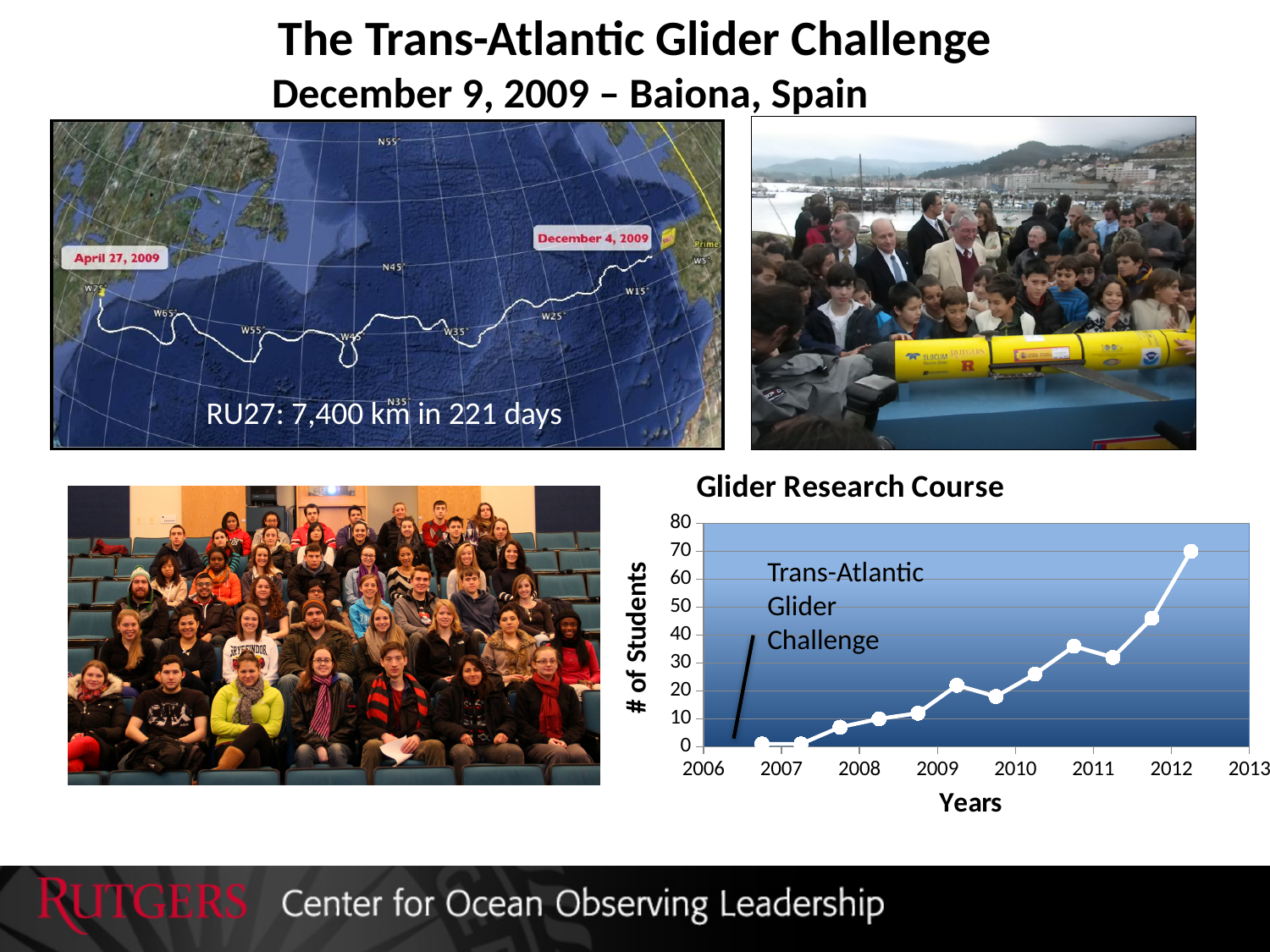
On the Glider Research Course chart, is the value of the highest point greater or less than 80? less What is the highest value shown on the y axis of the Glider Research Course chart? 80 On the Glider Research Course chart, is the value of the last (rightmost) point greater or less than 60? greater What kind of chart is the Glider Research Course chart? line chart What is the label of the y axis on the Glider Research Course chart? # of Students How many data points are plotted on the Glider Research Course chart? 12 What is the title of the chart on the slide? Glider Research Course Overall, do the values on the Glider Research Course chart rise or fall from 2006 to 2013? rise On the Glider Research Course chart, is the value of the first (leftmost) point greater or less than 10? less On the Glider Research Course chart, is the last point higher or lower than the first point? higher